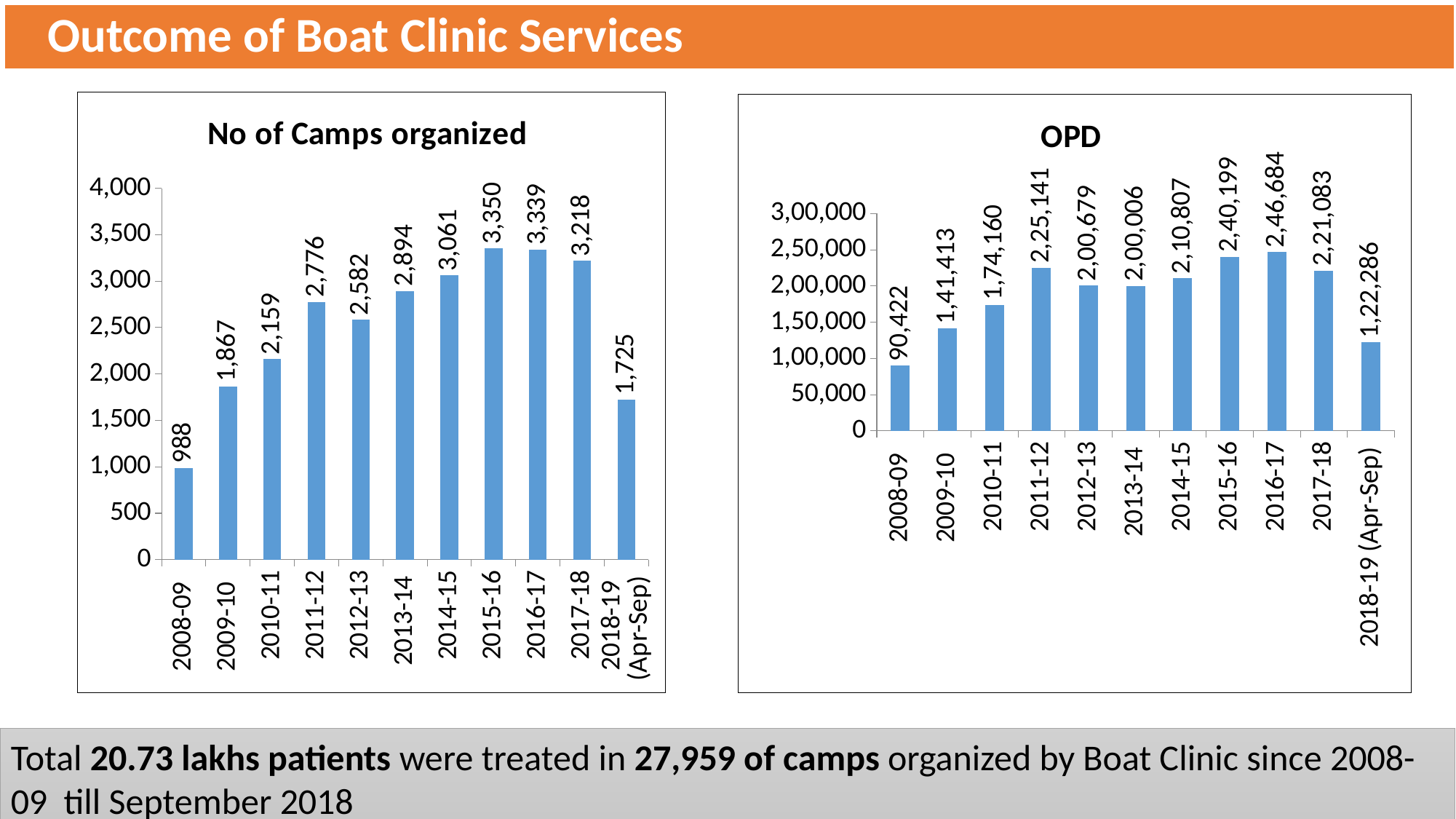
In the 'No of Camps organized' chart, which year has the lowest number of camps? 2008-09 In the 'No of Camps organized' chart, do the values rise or fall from 2008-09 to 2011-12? rise In the 'OPD' chart, which year has the lowest value? 2008-09 In the 'No of Camps organized' chart, how many camps were organized in 2013-14? 2,894 In the 'OPD' chart, is the value for 2018-19 (Apr-Sep) greater or less than 1,50,000? less What kind of chart is the 'OPD' chart? bar chart In the 'OPD' chart, which year has the highest value? 2016-17 In the 'No of Camps organized' chart, which year has the highest number of camps? 2015-16 In the 'No of Camps organized' chart, how many categories are shown on the x axis? 11 In the 'OPD' chart, is the value for 2010-11 larger or smaller than the value for 2011-12? smaller In the 'No of Camps organized' chart, what is the difference between the values for 2011-12 and 2012-13? 194 In the 'OPD' chart, what is the value for 2014-15? 2,10,807